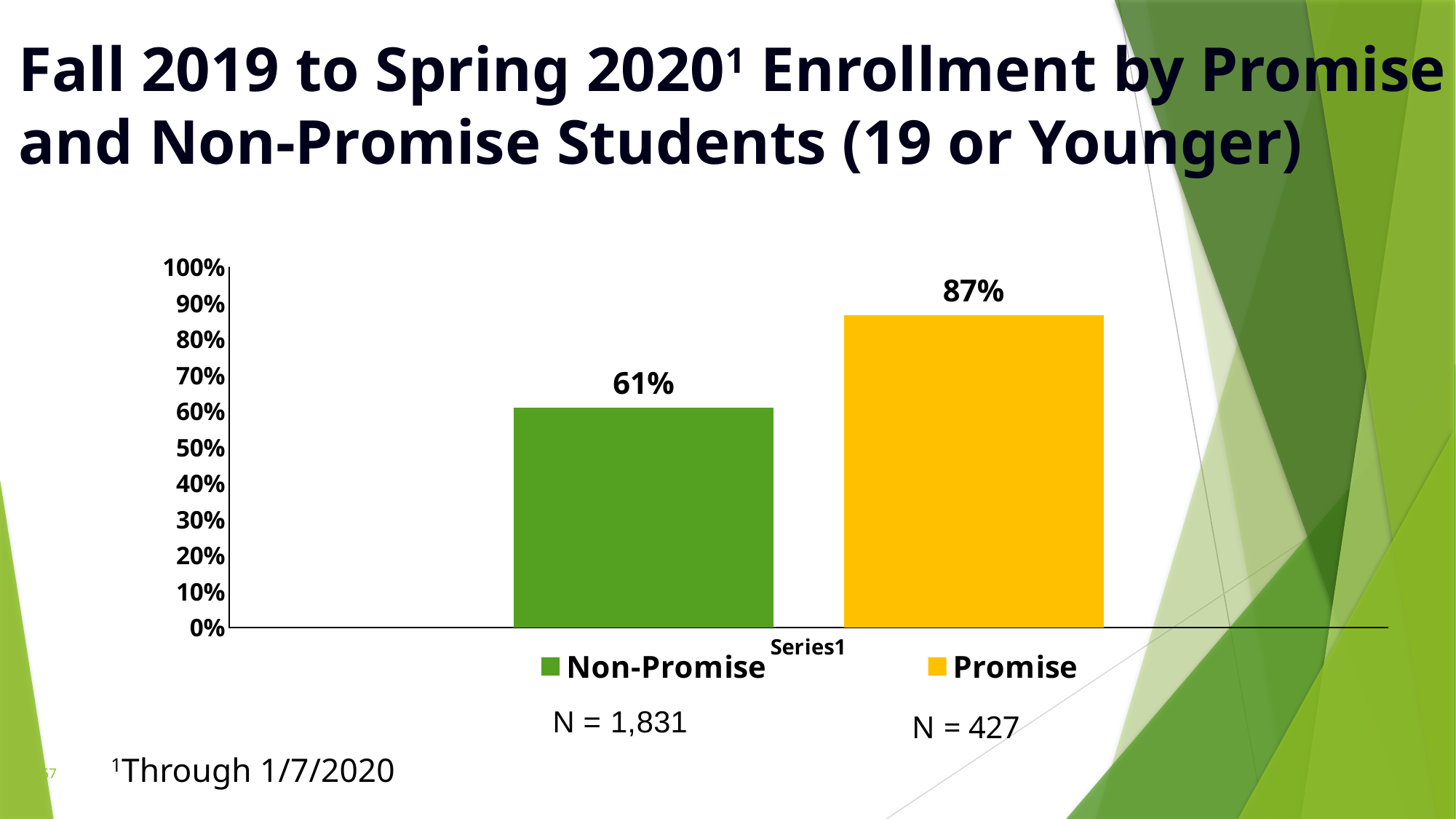
What kind of chart is shown on the slide? bar chart What is the value for Promise students? 87% What is the value for Non-Promise students? 61% What is the N shown for the Non-Promise group? N = 1,831 Is the value for Promise greater or less than 80%? greater What is the difference between the Promise and Non-Promise values? 26% How many bars are plotted in the chart? 2 Is the value for Non-Promise greater or less than 70%? less Which group has the higher enrollment percentage? Promise What colour is the Promise bar? yellow Which group has the lower enrollment percentage? Non-Promise How many series does the legend list? 2